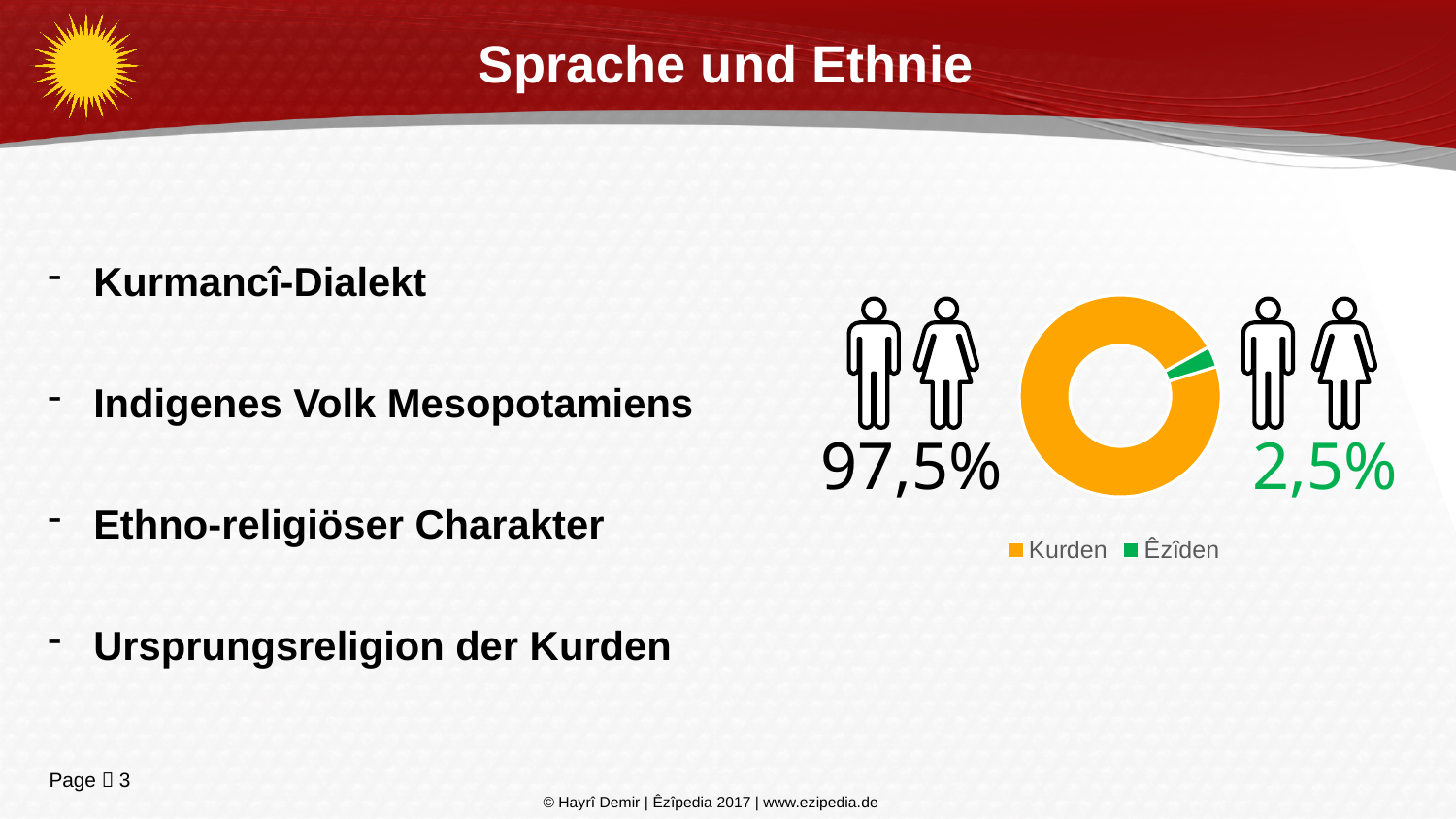
What percentage is shown for Êzîden? 2,5% What is the difference between the Kurden share and the Êzîden share? 95% How many entries does the chart's legend list? 2 What kind of chart is shown on the slide? pie chart (donut) What colour represents Êzîden in the chart? green What percentage is shown for Kurden? 97,5% What share of the chart does the Êzîden slice represent? 2,5% How many categories does the chart show? 2 Which category has the smallest share of the chart? Êzîden Which category has the largest share of the chart? Kurden What are the two entries listed in the chart's legend? Kurden and Êzîden Which is larger, the share for Kurden or the share for Êzîden? Kurden